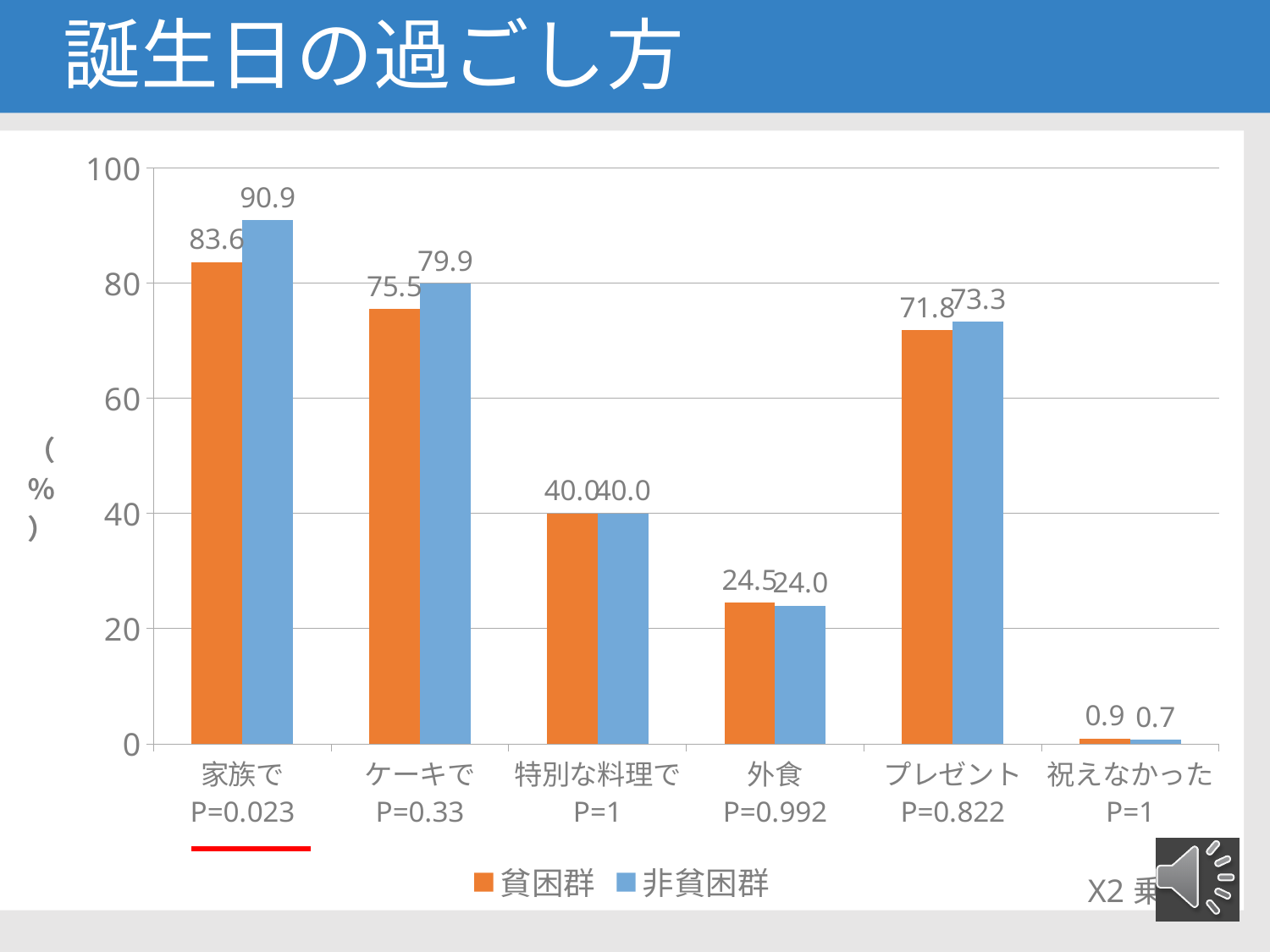
What is the difference between the 非貧困群 and 貧困群 values in the 家族で category? 7.3 How many categories are shown on the x axis? 6 How many series does the legend list? 2 What is the value for 非貧困群 in the ケーキで category? 79.9 Which series is shown in orange in the legend? 貧困群 What is the value for 非貧困群 in the 家族で category? 90.9 Which category has the lowest value for 貧困群? 祝えなかった Which is larger in the プレゼント category, the value for 貧困群 or for 非貧困群? 非貧困群 What is the value for 貧困群 in the 家族で category? 83.6 What is the value for 貧困群 in the 外食 category? 24.5 Which category has the highest value for 非貧困群? 家族で What type of chart is shown on the slide? bar chart